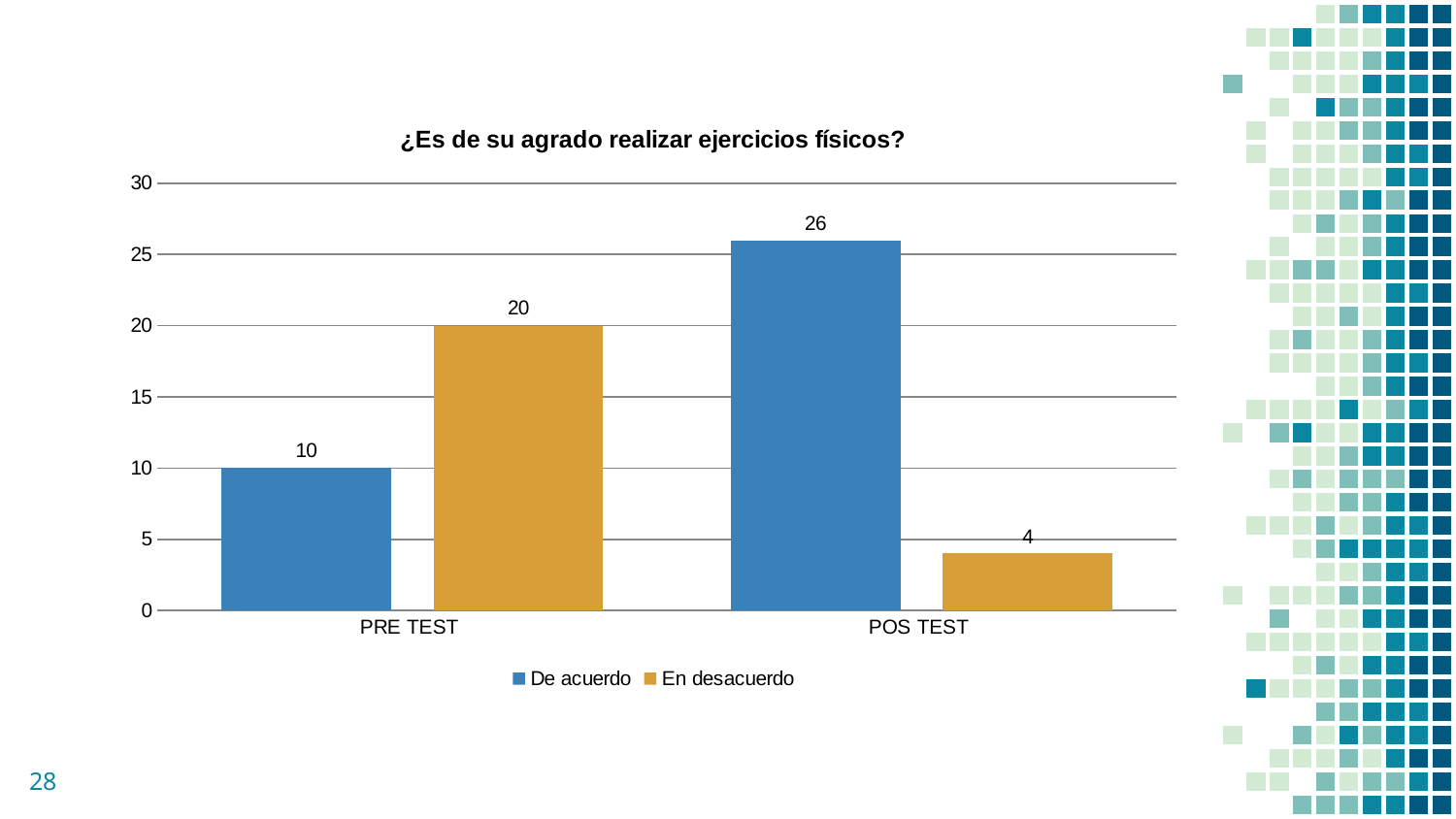
How many categories are shown on the x axis? 2 What is the difference between De acuerdo in POS TEST and De acuerdo in PRE TEST? 16 What is the value for En desacuerdo in PRE TEST? 20 How many series does the legend list? 2 Which bar has the lowest value on the chart? En desacuerdo, POS TEST What is the title of the chart? ¿Es de su agrado realizar ejercicios físicos? What is the value for En desacuerdo in POS TEST? 4 What kind of chart is shown on the slide? Bar chart What is the value for De acuerdo in POS TEST? 26 What is the value for De acuerdo in PRE TEST? 10 Which is larger in PRE TEST: De acuerdo or En desacuerdo? En desacuerdo Which bar has the highest value on the chart? De acuerdo, POS TEST